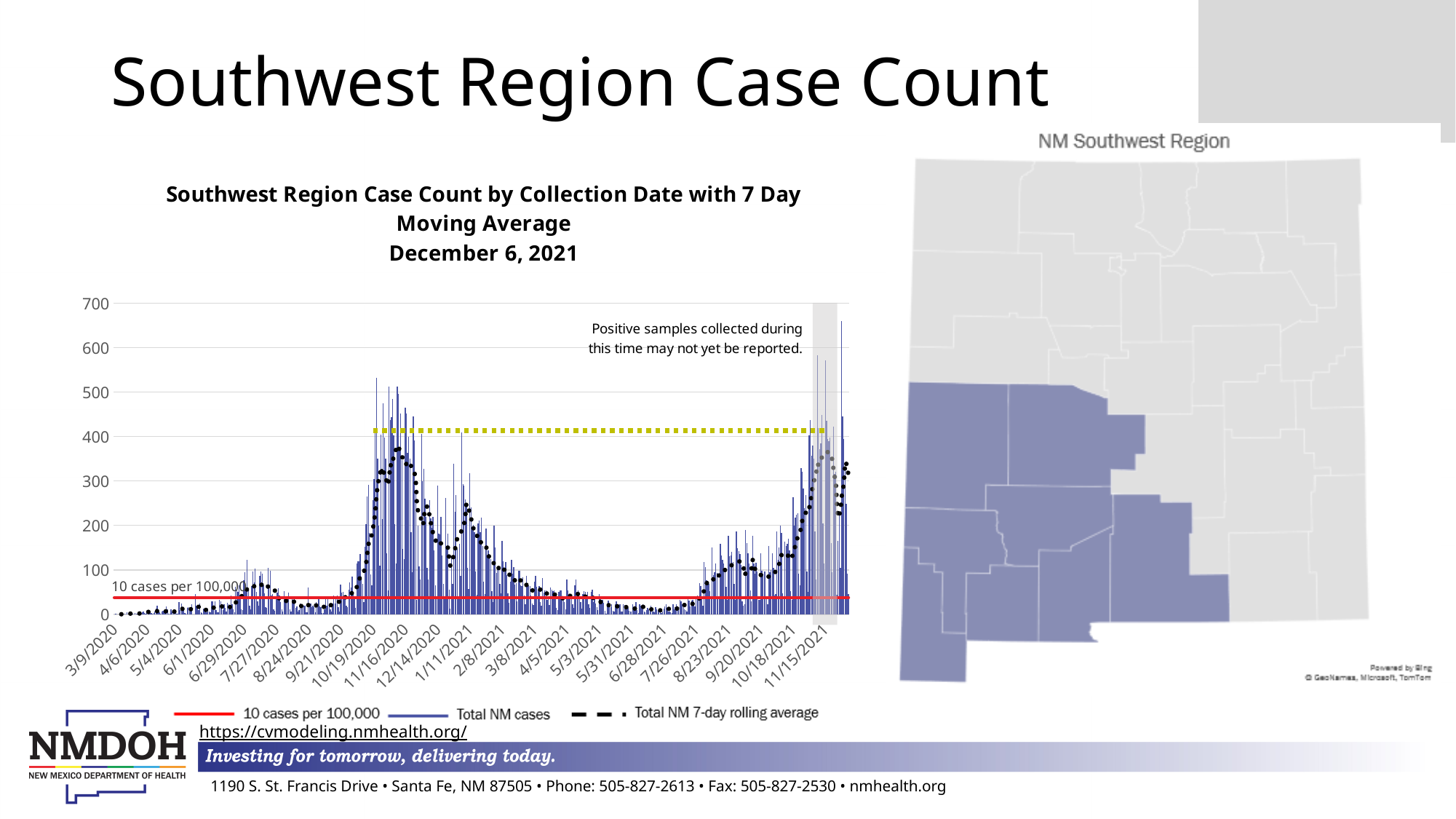
Is the peak of the 7-day rolling average in November 2020 greater or less than 300? greater Is the 7-day rolling average around 5/31/2021 greater or less than 100? less What is the date given in the title of the case count chart? December 6, 2021 What is the highest value shown on the y axis of the case count chart? 700 What is the last date label shown on the x axis of the case count chart? 11/15/2021 What kind of chart is used to show the daily Southwest Region case counts? bar chart Between 11/16/2020 and 3/8/2021, does the 7-day rolling average generally rise or fall? fall How many entries does the legend of the case count chart list? 3 What is the first date shown on the x axis of the case count chart? 3/9/2020 Is the tallest daily case bar in the chart greater or less than 600? greater Between 7/26/2021 and 11/15/2021, does the 7-day rolling average generally rise or fall? rise What does the red horizontal line in the case count chart represent, according to the legend? 10 cases per 100,000